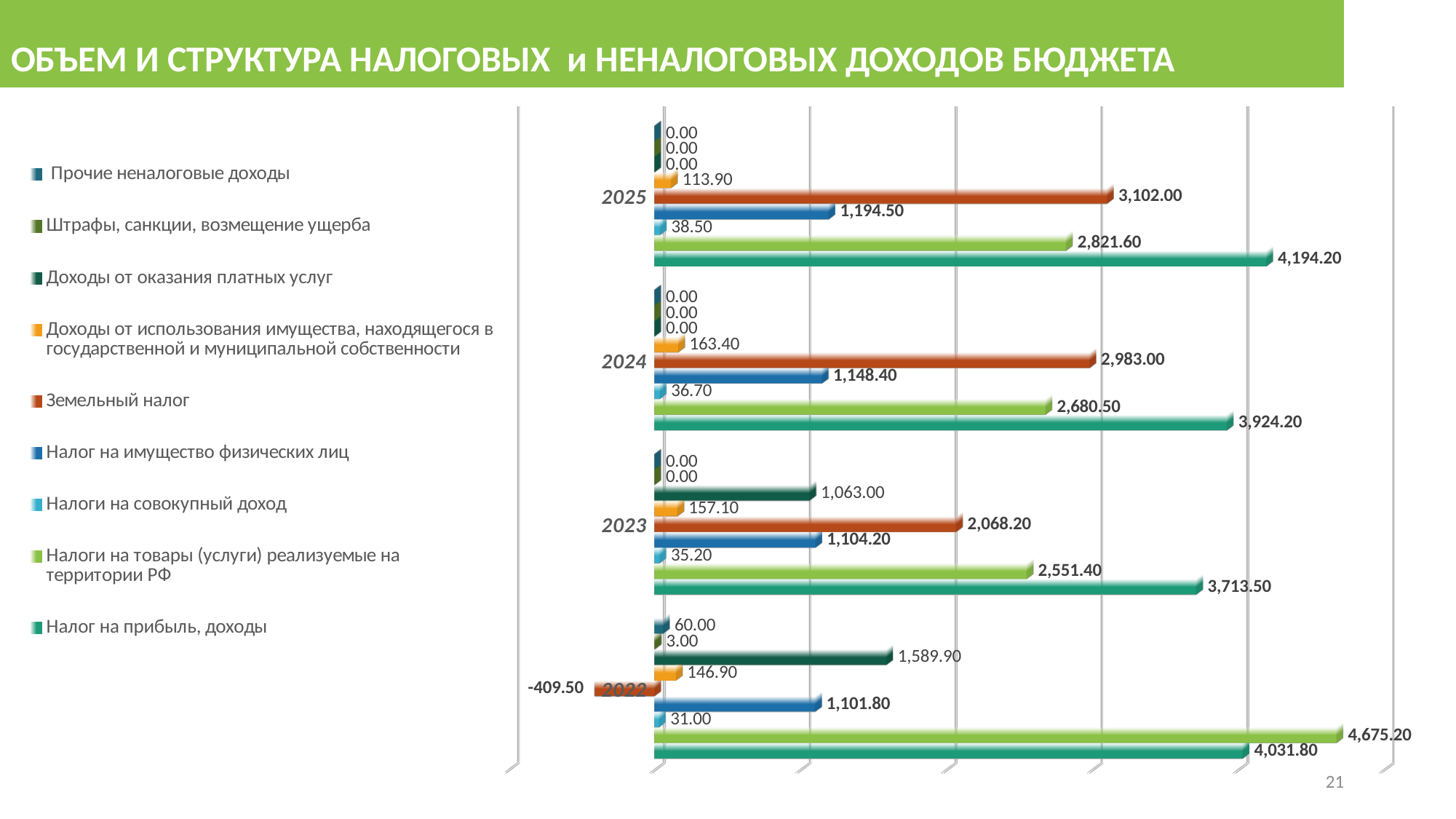
In which year is Земельный налог lowest? 2022 What is the value of Доходы от оказания платных услуг for 2023? 1,063.00 What is the value of Налог на прибыль, доходы for 2025? 4,194.20 What is the difference between Налог на прибыль, доходы in 2025 and in 2024? 270.00 What kind of chart is shown on the slide? bar chart How many series does the legend list? 9 Which is larger in 2023: Земельный налог or Налоги на товары (услуги) реализуемые на территории РФ? Налоги на товары (услуги) реализуемые на территории РФ In which year is Налоги на товары (услуги) реализуемые на территории РФ highest? 2022 What is the value of Земельный налог for 2022? -409.50 What is the value of Налоги на совокупный доход for 2024? 36.70 Does Налог на прибыль, доходы rise or fall from 2023 to 2025? rise How many years (categories) are shown on the chart? 4